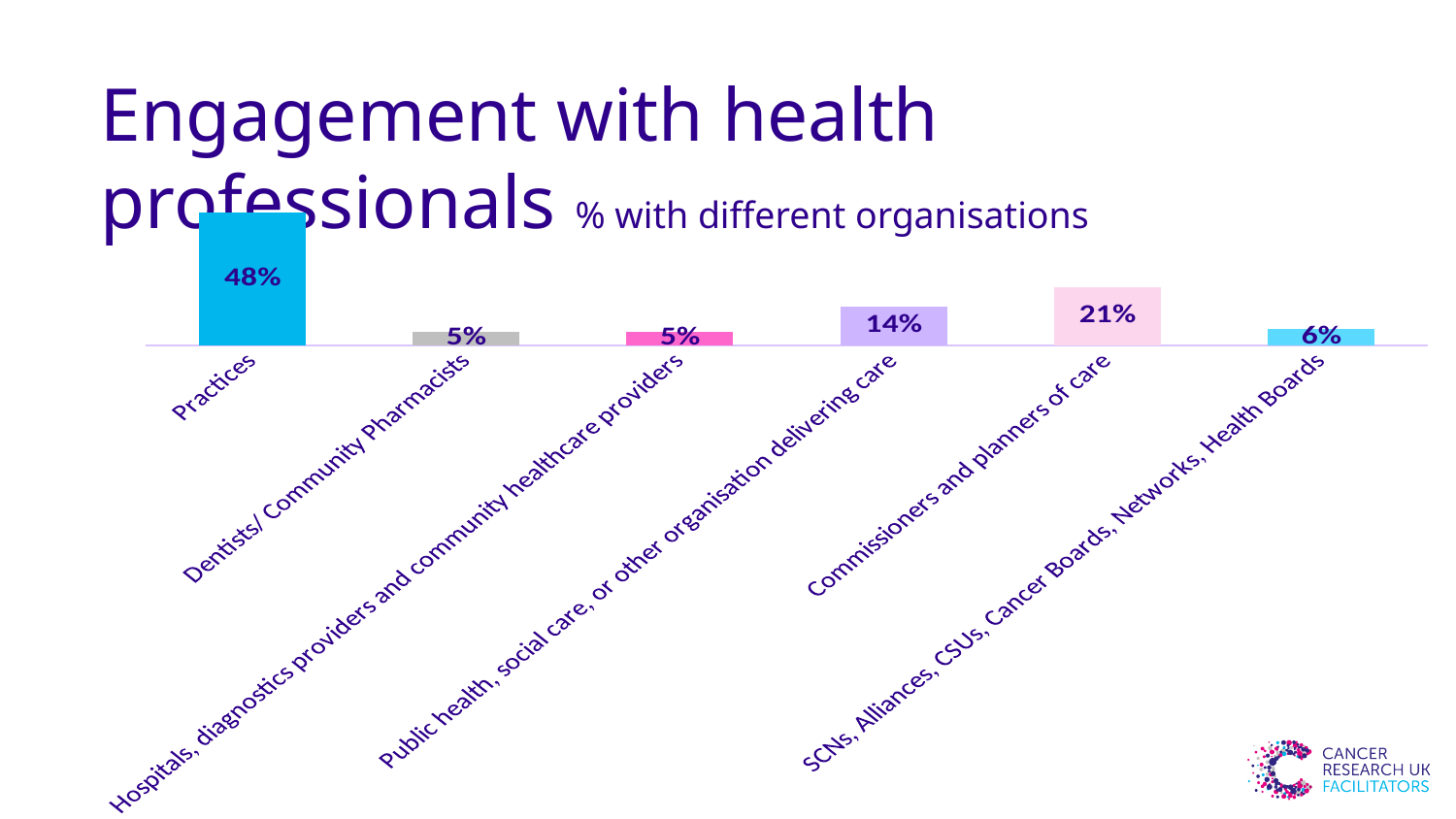
What is the value for Dentists/ Community Pharmacists? 5% What is the value for Commissioners and planners of care? 21% What is the value for SCNs, Alliances, CSUs, Cancer Boards, Networks, Health Boards? 6% How many categories are shown in the chart? 6 What is the value for Public health, social care, or other organisation delivering care? 14% Which is larger: the value for Public health, social care, or other organisation delivering care, or the value for SCNs, Alliances, CSUs, Cancer Boards, Networks, Health Boards? Public health, social care, or other organisation delivering care What is the difference between the values for Commissioners and planners of care and Hospitals, diagnostics providers and community healthcare providers? 16% What is the difference between the values for Practices and Commissioners and planners of care? 27% Which category has the highest value? Practices What is the subtitle text shown next to the slide title? % with different organisations What kind of chart is shown on the slide? Bar chart What percentage of engagement is with Practices? 48%